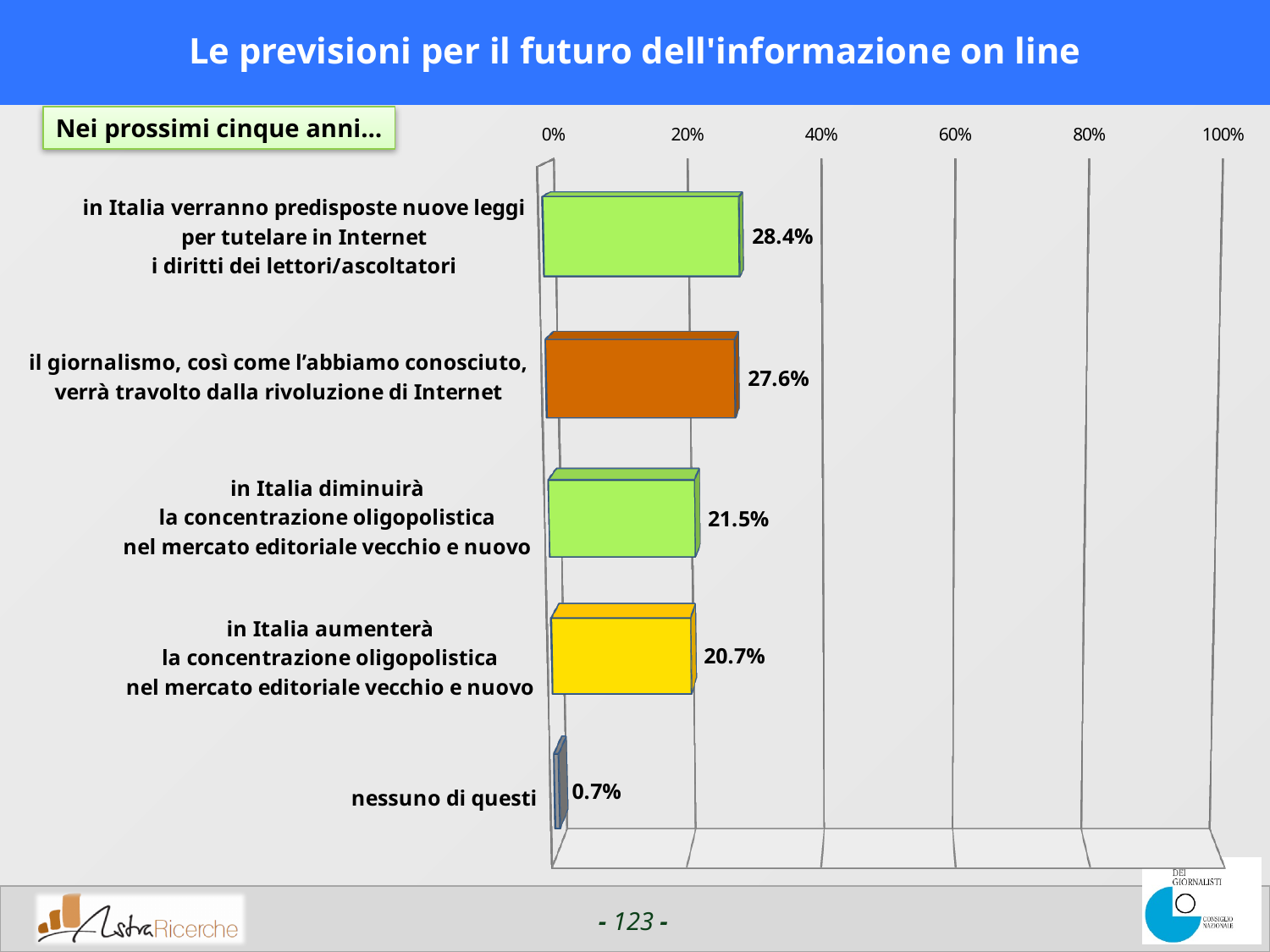
What is the value for 'il giornalismo, così come l'abbiamo conosciuto, verrà travolto dalla rivoluzione di Internet'? 27.6% Is the value for 'in Italia verranno predisposte nuove leggi per tutelare in Internet i diritti dei lettori/ascoltatori' greater or less than 20%? greater What is the difference between the value for 'in Italia diminuirà la concentrazione oligopolistica' and the value for 'in Italia aumenterà la concentrazione oligopolistica'? 0.8% How many categories are plotted in the chart? 5 Which is larger: the value for 'in Italia aumenterà la concentrazione oligopolistica' or the value for 'il giornalismo ... verrà travolto dalla rivoluzione di Internet'? il giornalismo ... verrà travolto dalla rivoluzione di Internet What is the difference between the highest value (28.4%) and the value for 'nessuno di questi'? 27.7% What is the value for 'nessuno di questi'? 0.7% What percentage of respondents predict that in Italy new laws will be prepared to protect readers'/listeners' rights on the Internet? 28.4% Which category has the lowest value in the chart? nessuno di questi What kind of chart is shown on the slide? bar chart Which category has the highest value in the chart? in Italia verranno predisposte nuove leggi per tutelare in Internet i diritti dei lettori/ascoltatori What percentage is shown for 'in Italia diminuirà la concentrazione oligopolistica nel mercato editoriale vecchio e nuovo'? 21.5%